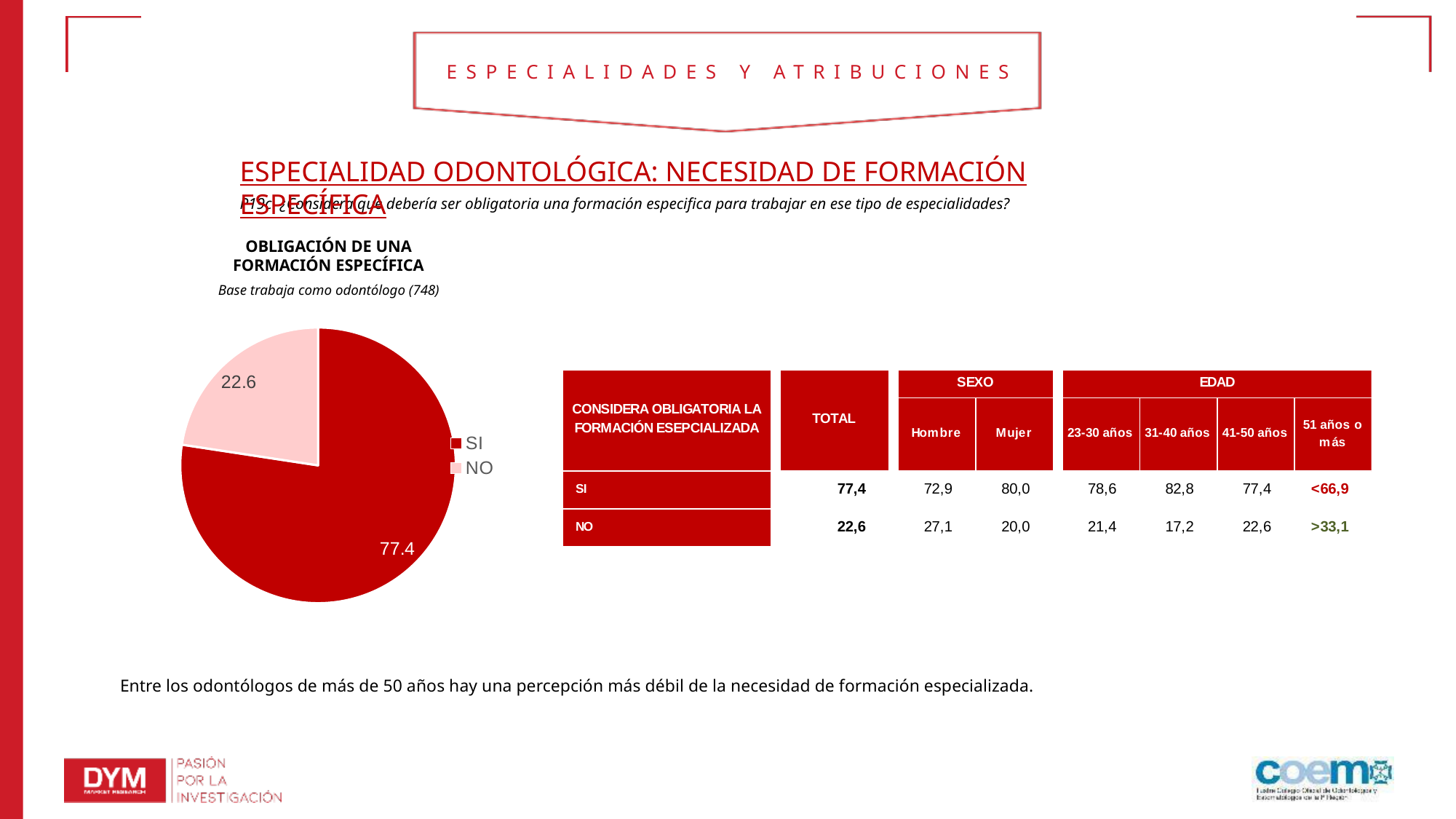
Which is larger in the pie chart, SI or NO? SI How many entries does the pie chart legend list? 2 What kind of chart is shown on the slide? pie chart Which slice of the pie chart is the largest? SI What share of the pie does the NO slice represent? 22.6 What is the difference between the SI and NO values in the pie chart? 54.8 Which slice of the pie chart is the smallest? NO What is the value for NO in the pie chart? 22.6 What is the value for SI in the pie chart? 77.4 How many slices does the pie chart have? 2 What is the base size stated under the pie chart title? 748 What is the title of the pie chart? OBLIGACIÓN DE UNA FORMACIÓN ESPECÍFICA